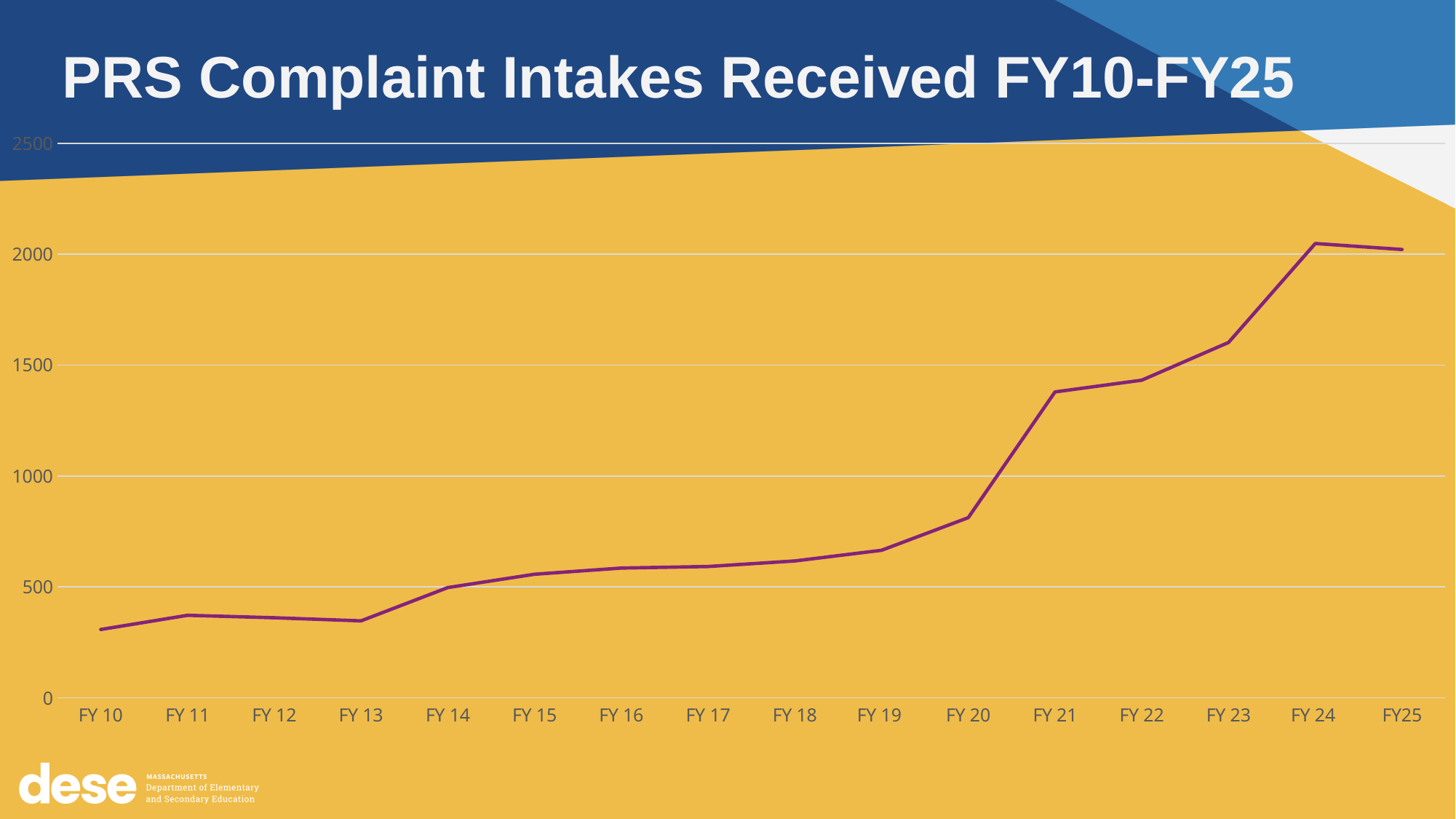
What kind of chart is shown on the slide? line chart Is the value for FY 10 greater or less than 500? less How many fiscal years are plotted on the x axis? 16 Is the value for FY 24 greater or less than 2000? greater Which fiscal year has the highest number of complaint intakes? FY 24 Which has more complaint intakes, FY 20 or FY 21? FY 21 Do complaint intakes generally rise or fall from FY 10 to FY 25? rise Is the value for FY 20 greater or less than 1000? less What is the title of the chart? PRS Complaint Intakes Received FY10-FY25 Which fiscal year has the lowest number of complaint intakes? FY 10